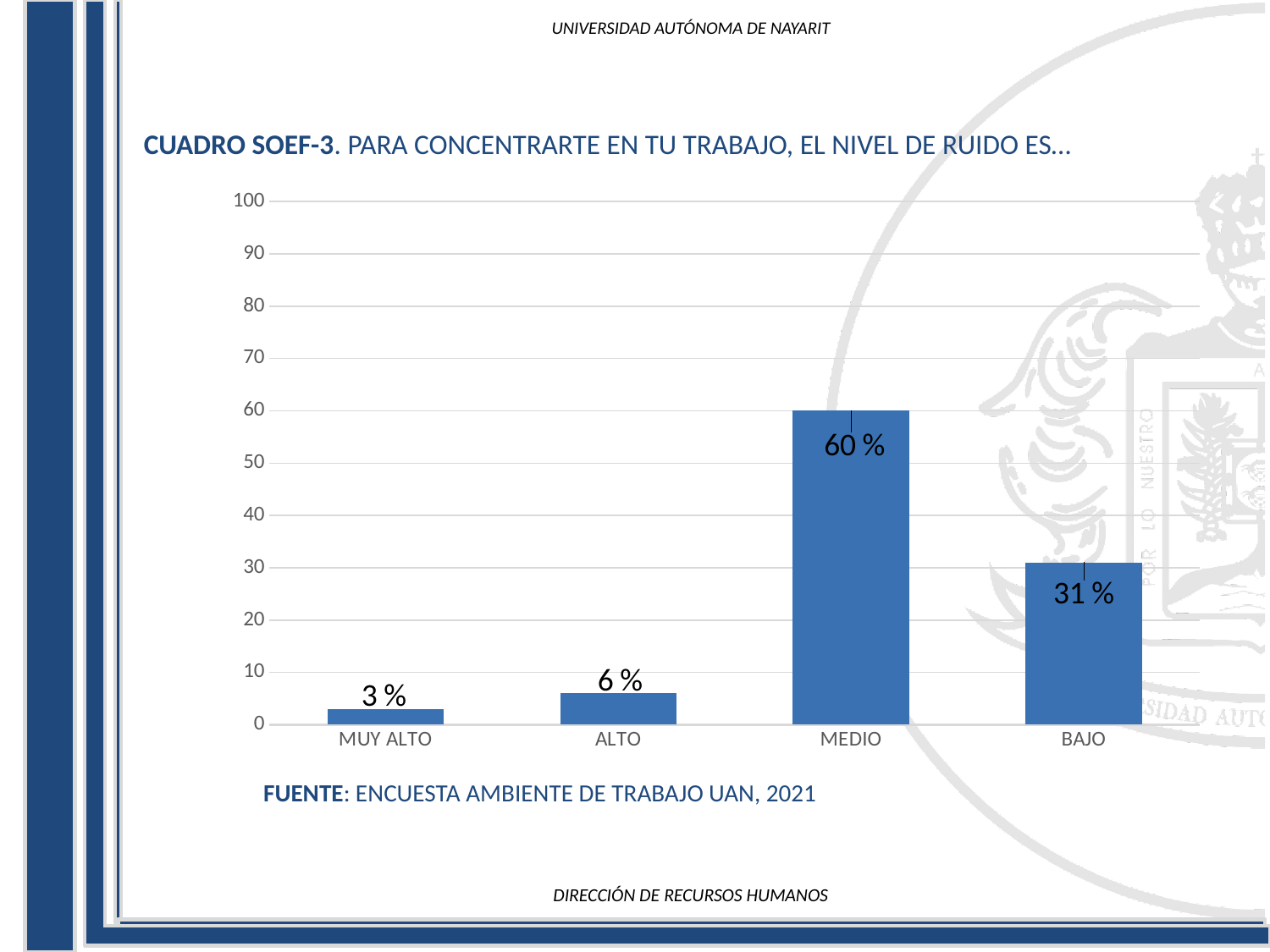
Which category has the lowest value? MUY ALTO What source is cited below the chart? ENCUESTA AMBIENTE DE TRABAJO UAN, 2021 What is the value for MEDIO? 60 % What is the value for ALTO? 6 % What is the value for BAJO? 31 % Which is larger, the value for ALTO or the value for MUY ALTO? ALTO What kind of chart is shown on the slide? bar chart How many categories are shown on the x axis? 4 Is the value for BAJO greater or less than 40? less What is the value for MUY ALTO? 3 % Which category has the highest value? MEDIO What is the difference between the values for MEDIO and BAJO? 29 %